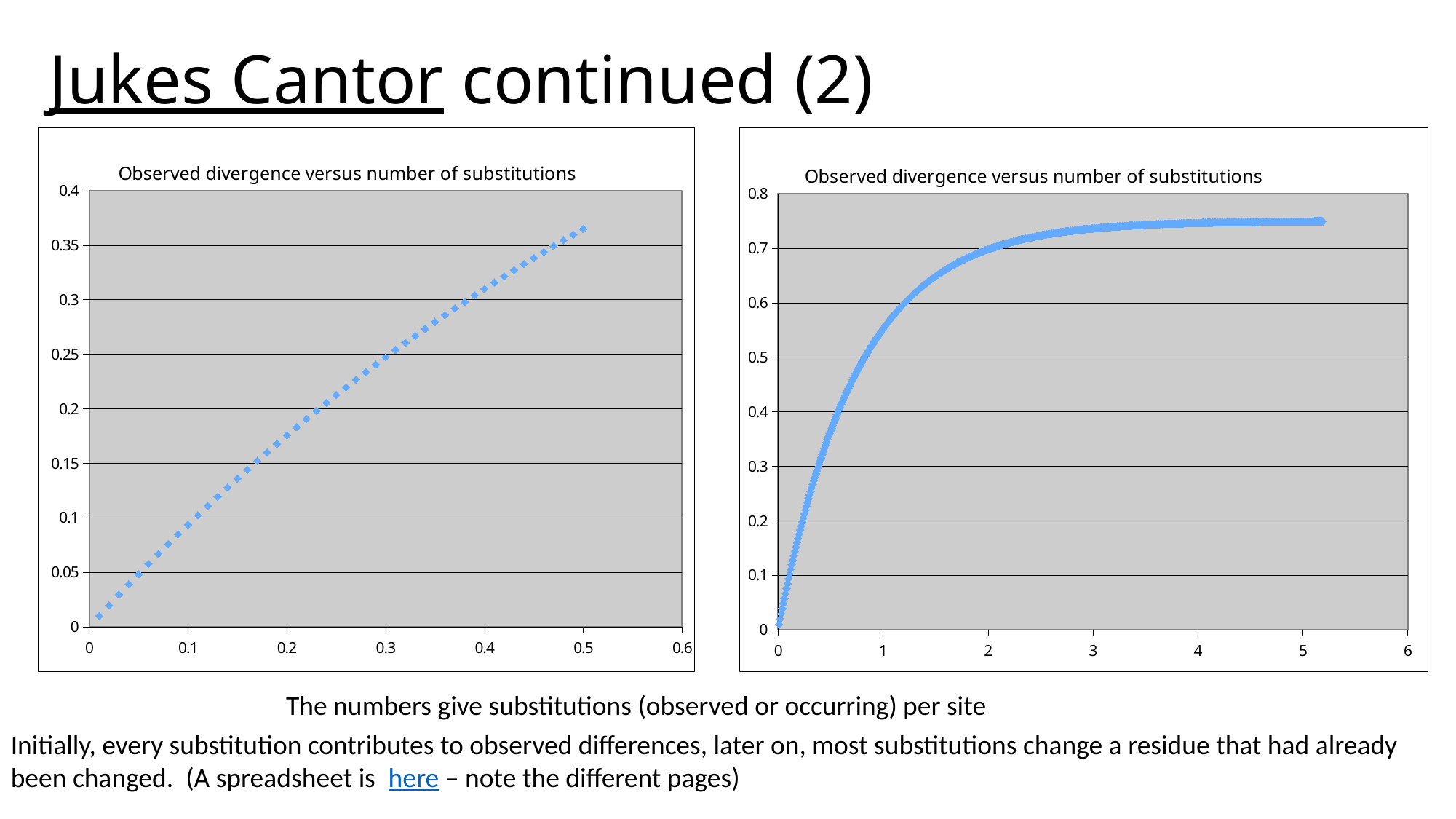
What kind of chart is the chart on the right? scatter chart In the chart on the right, do the values rise or fall as the x axis increases? rise What is the title of the chart on the left? Observed divergence versus number of substitutions In the chart on the right, is the value at x = 2 greater or less than 0.6? greater In the chart on the right, is the value at x = 3 greater or less than 0.7? greater In the chart on the left, do the values rise or fall as the x axis increases? rise In the chart on the left, is the value at x = 0.5 greater or less than 0.3? greater What is the highest value shown on the y axis of the chart on the right? 0.8